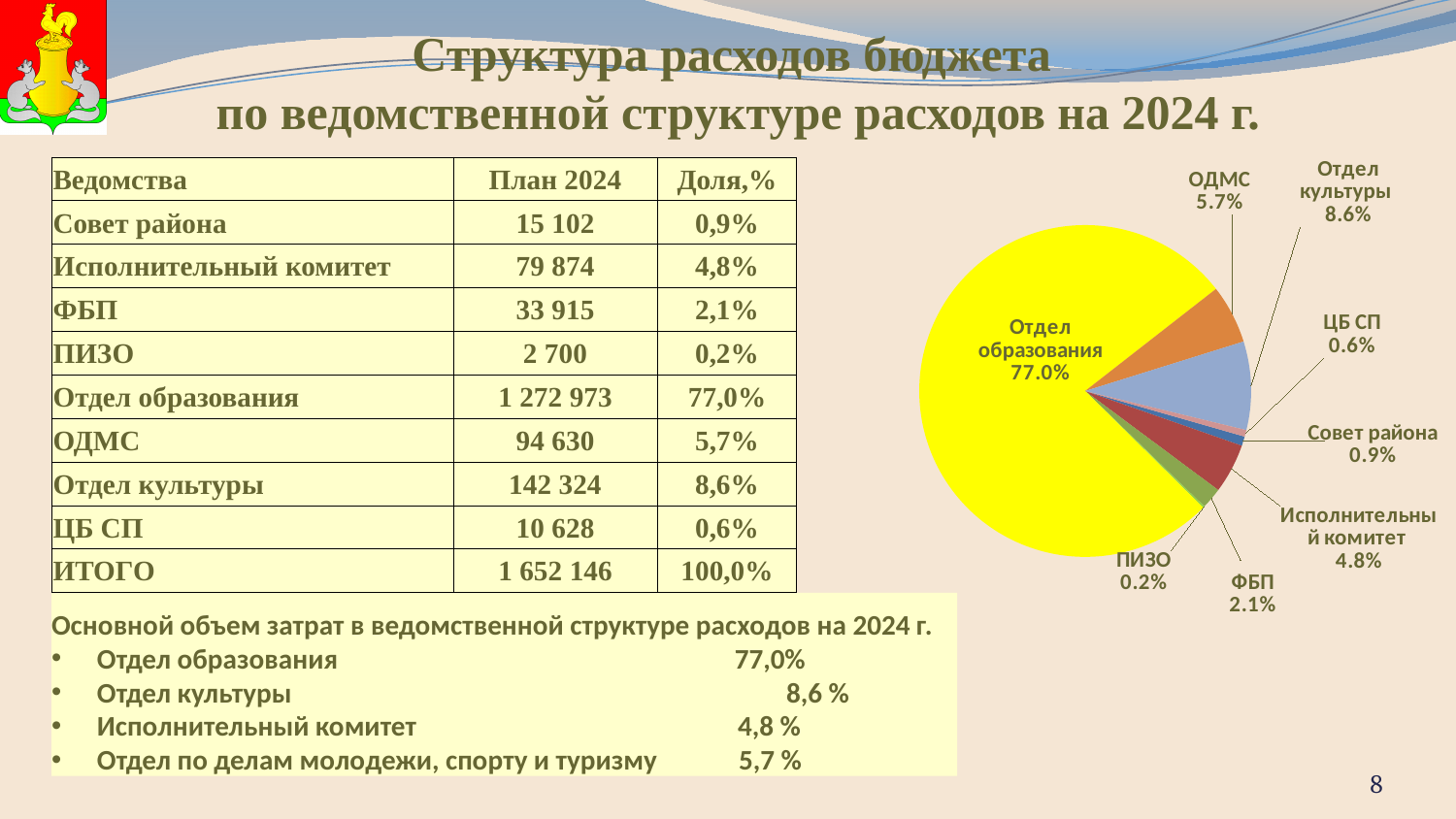
What kind of chart is shown on the slide? pie chart What share of the pie chart does Отдел образования have? 77.0% Which category has the smallest slice in the pie chart? ПИЗО What is the difference between the shares of Отдел культуры and ОДМС in the pie chart? 2.9% What is the value shown for ЦБ СП in the pie chart? 0.6% How many slices does the pie chart have? 8 Which category has the largest slice in the pie chart? Отдел образования What is the value shown for Исполнительный комитет in the pie chart? 4.8% What is the value shown for ОДМС in the pie chart? 5.7% Which is larger in the pie chart: Отдел культуры or ОДМС? Отдел культуры What is the value shown for Отдел культуры in the pie chart? 8.6% What colour is the Отдел образования slice in the pie chart? yellow